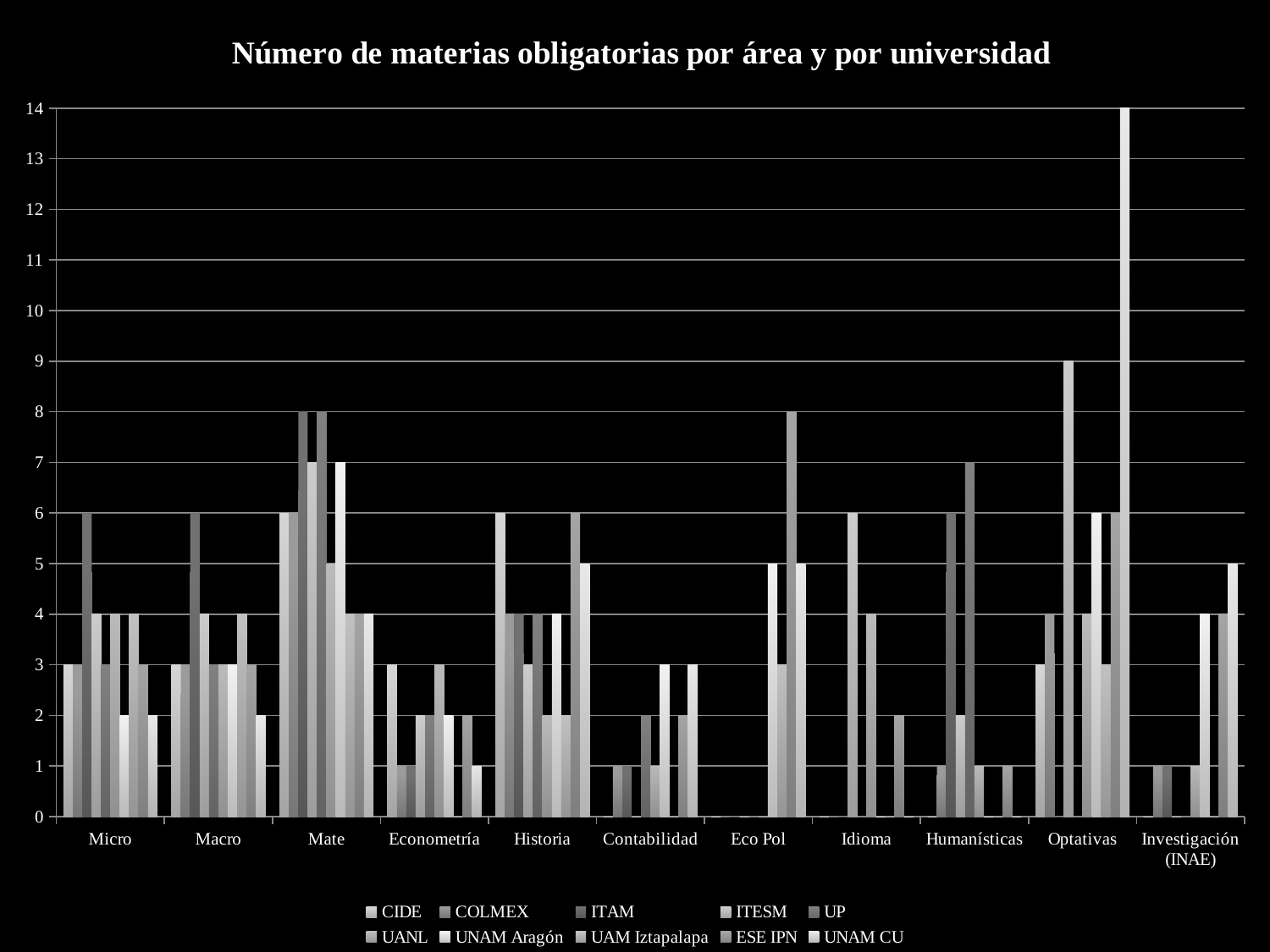
Is the tallest bar in the Optativas category greater or less than 10? greater Which category has the taller tallest bar, Mate or Micro? Mate What is the title of the chart? Número de materias obligatorias por área y por universidad What kind of chart is shown on the slide? bar chart Is the tallest bar in the Econometría category greater or less than 5? less What is the value of the tallest bar in the chart? 14 What is the highest value shown on the y axis? 14 How many series (universities) does the legend list? 10 How many categories (areas) are shown along the x axis? 11 Which category contains the tallest bar in the chart? Optativas